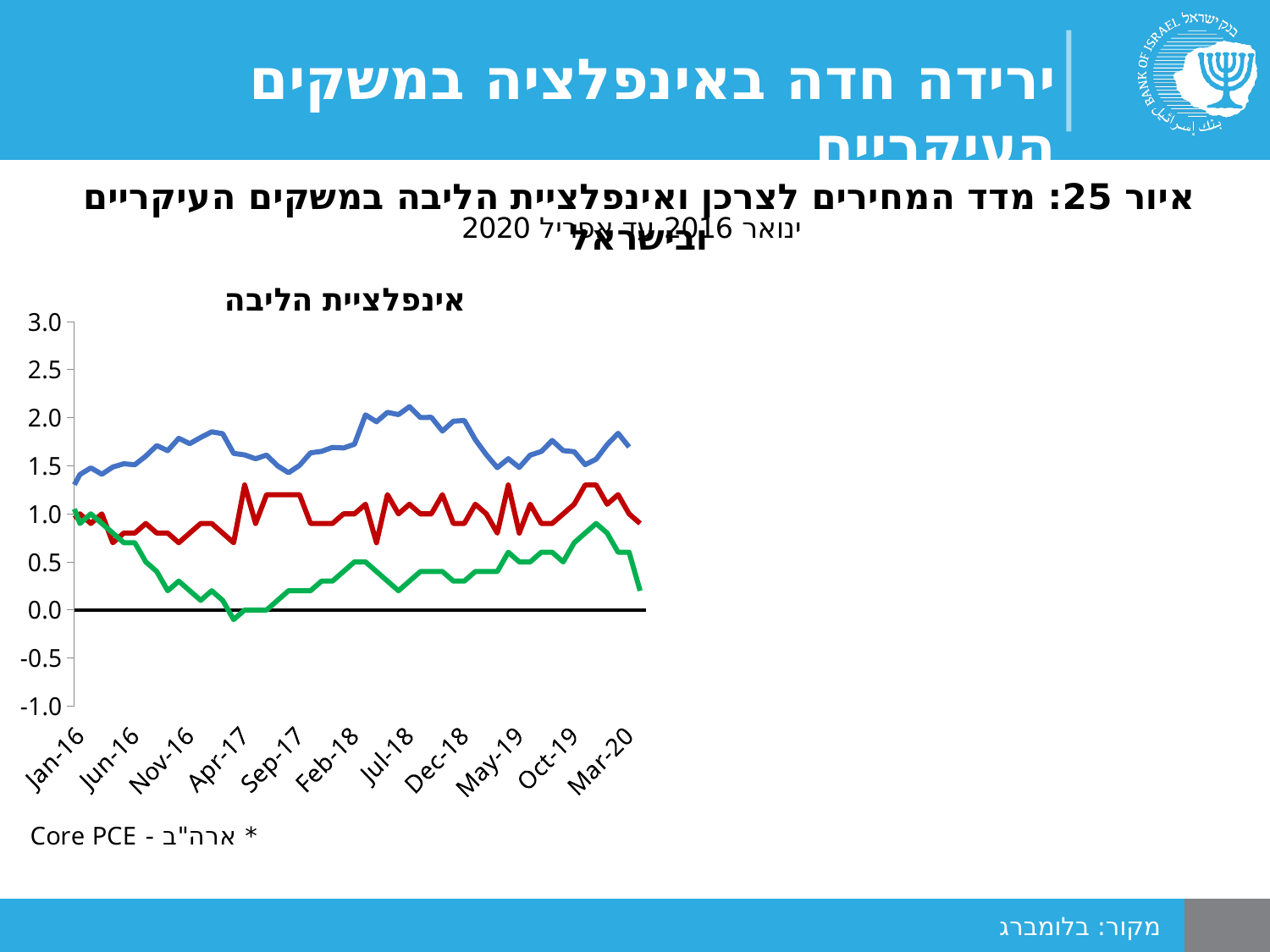
What is the title of the chart? אינפלציית הליבה What is the highest value shown on the y axis? 3.0 How many lines are plotted on the chart? 3 Is the value of the blue line at Mar-20 greater or less than 1.5? greater How many date labels are shown on the x axis? 11 Which line is higher at Jul-18, the blue line or the red line? the blue line What kind of chart is shown on the slide? line chart Is the value of the green line at Jan-16 greater or less than 0.5? greater Which line is higher at Mar-20, the blue line or the green line? the blue line Does the green line rise or fall between Jan-16 and Apr-17? fall Is the value of the blue line at Jan-16 greater or less than 1.5? less